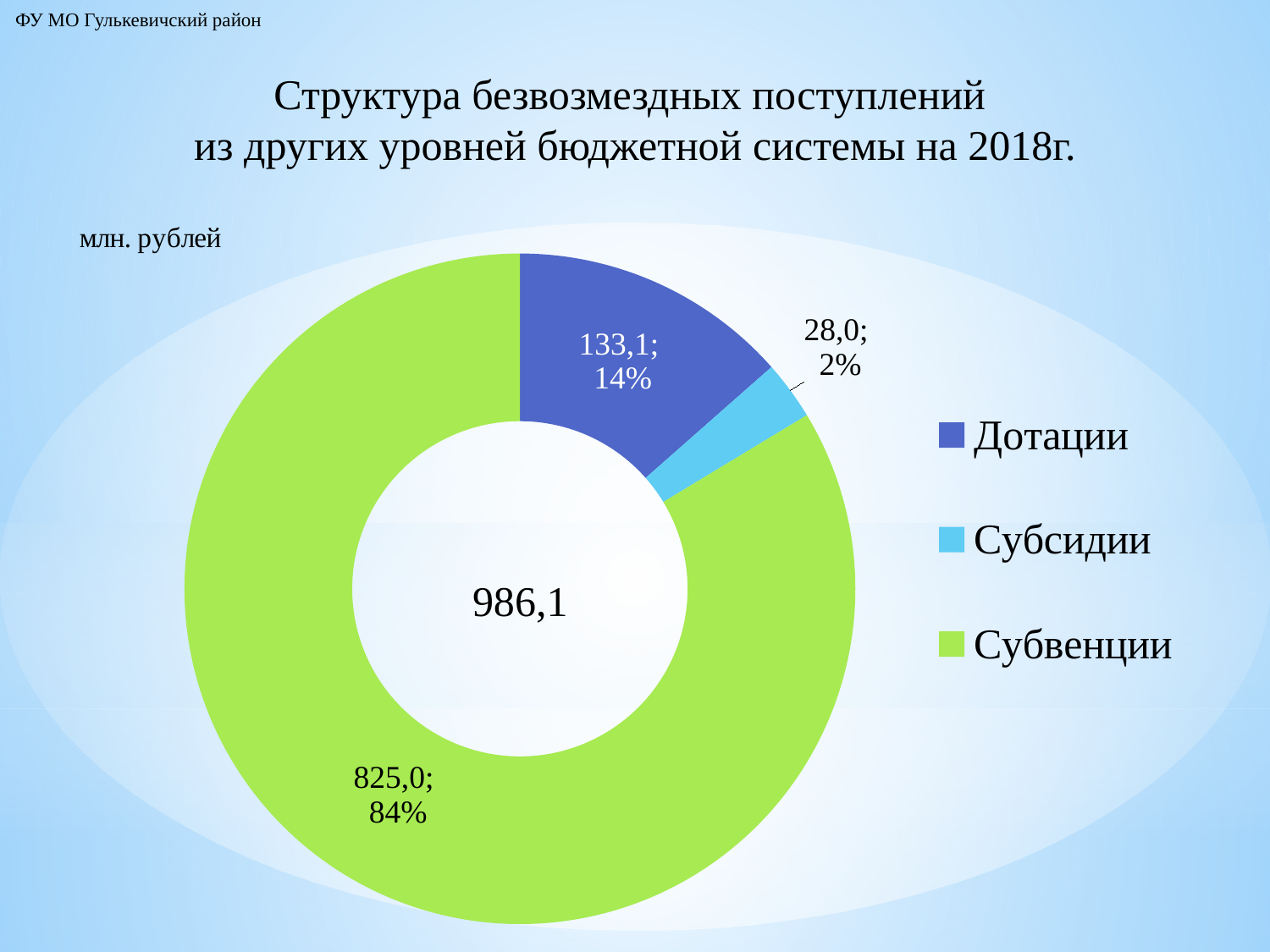
What share of the chart does Субвенции represent? 84% Which is larger, the value for Дотации or the value for Субсидии? Дотации What is the value for Дотации? 133,1 What share of the chart does Дотации represent? 14% Which category has the smallest share of the chart? Субсидии What kind of chart is shown on the slide? Pie chart (doughnut) What is the value for Субвенции? 825,0 What is the difference between the values for Субвенции and Дотации? 691,9 What total value is shown in the centre of the chart? 986,1 How many categories does the chart show? 3 What is the value for Субсидии? 28,0 Which category has the largest share of the chart? Субвенции